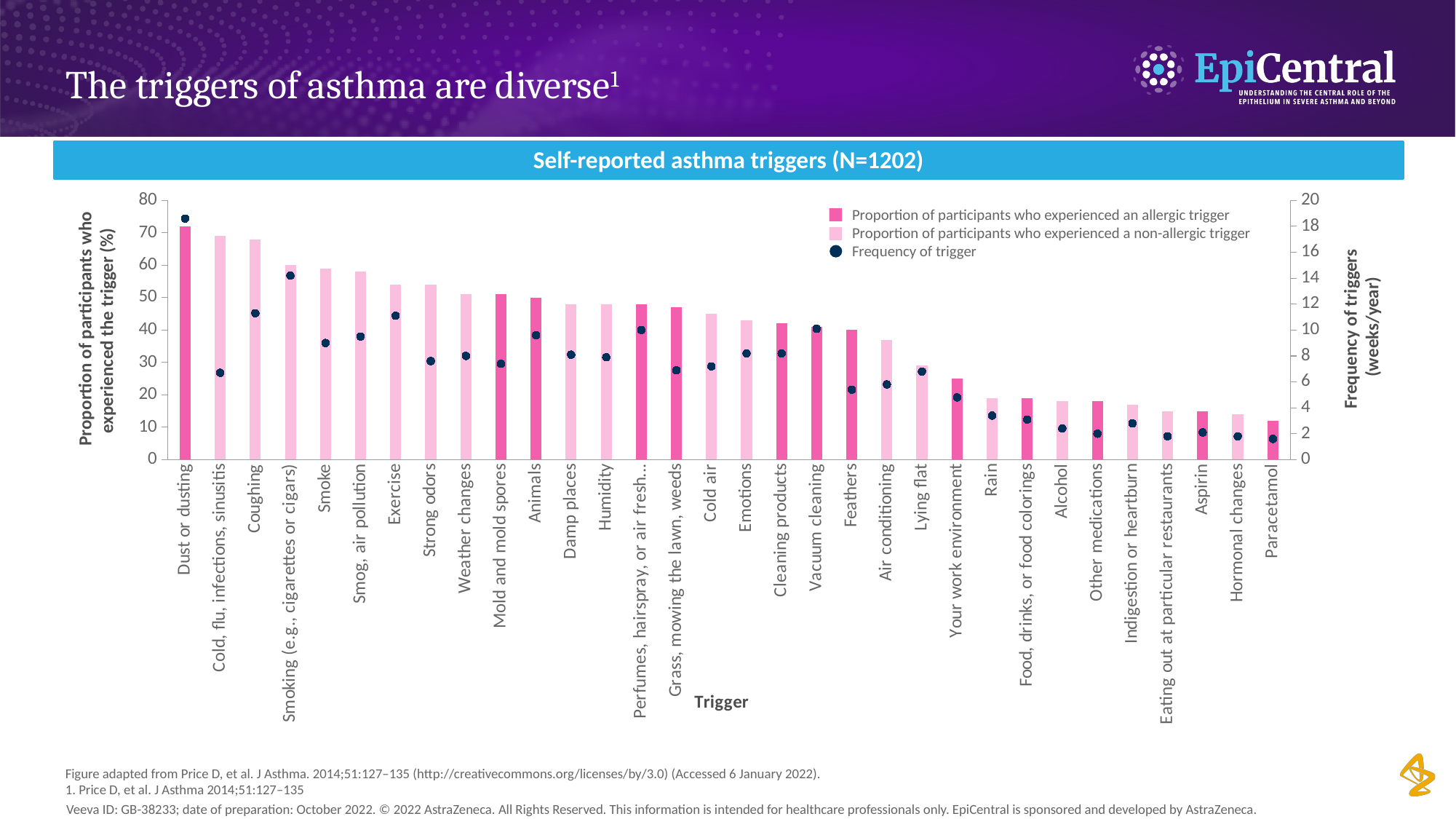
Is the proportion of participants for Coughing greater or less than 60%? greater How many triggers are listed along the x axis of the chart? 32 How many series does the legend list? 3 Do the bar values rise or fall moving from left to right along the x axis? Fall Is the proportion of participants for Exercise greater or less than 50%? greater Is the frequency of trigger for Dust or dusting greater or less than 16 weeks/year? greater What is the title of the chart? Self-reported asthma triggers (N=1202) What kind of chart is shown on the slide? Bar chart with a line/dot series (combination chart) Which has a higher proportion of participants, Exercise or Emotions? Exercise Which trigger has the lowest proportion of participants who experienced it? Paracetamol Which trigger has the highest proportion of participants who experienced it? Dust or dusting